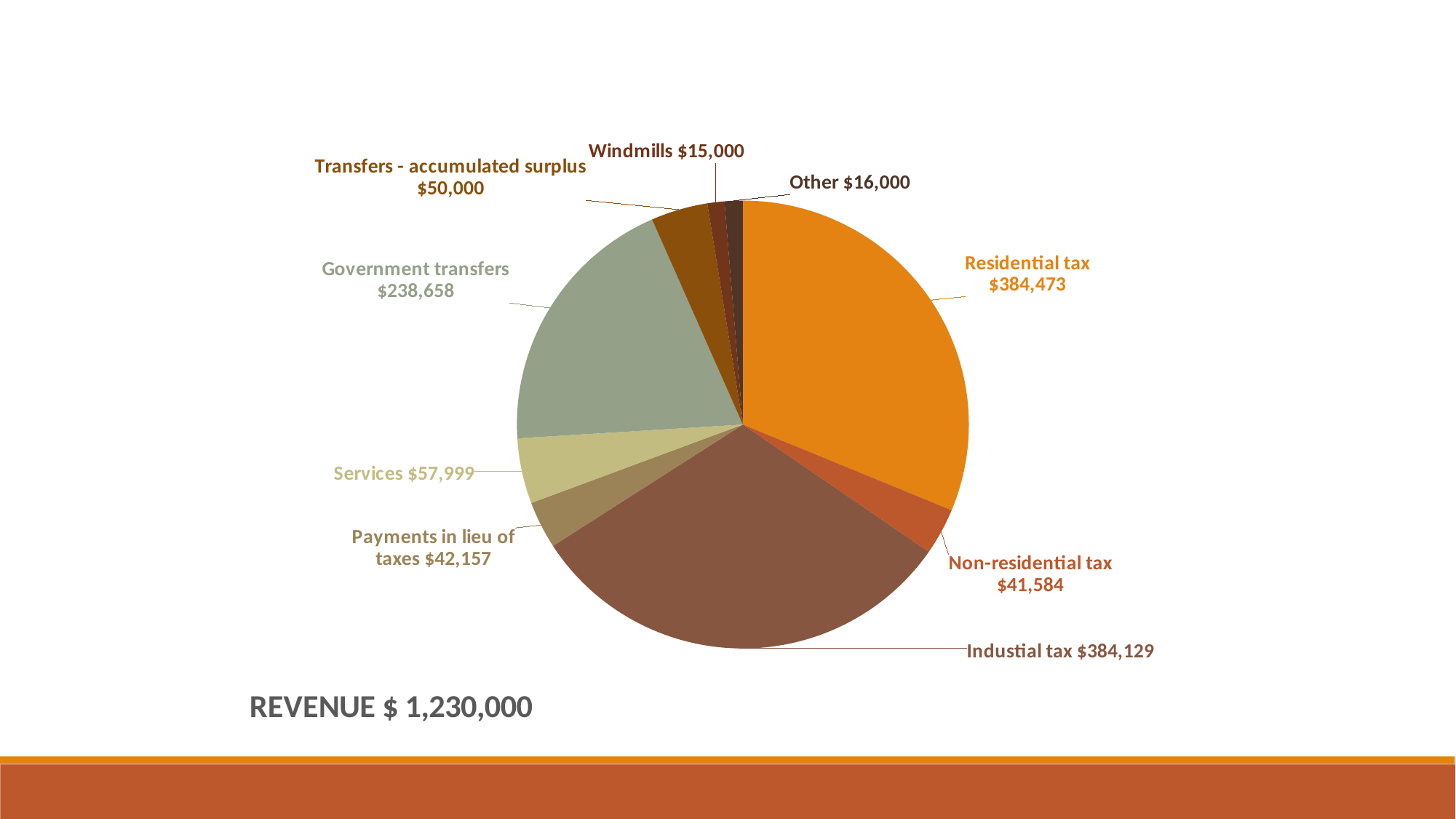
Which is larger, Non-residential tax or Industrial tax? Industrial tax What is the value for Windmills? $15,000 What is the value for Government transfers? $238,658 What is the value for Residential tax? $384,473 What is the value for Transfers - accumulated surplus? $50,000 What kind of chart is shown on the slide? Pie chart How many slices does the pie chart have? 9 What is the difference between Government transfers and Services? $180,659 Which is larger, Government transfers or Services? Government transfers What is the difference between Residential tax and Non-residential tax? $342,889 What is the value for Payments in lieu of taxes? $42,157 What total revenue is stated on the slide? $ 1,230,000